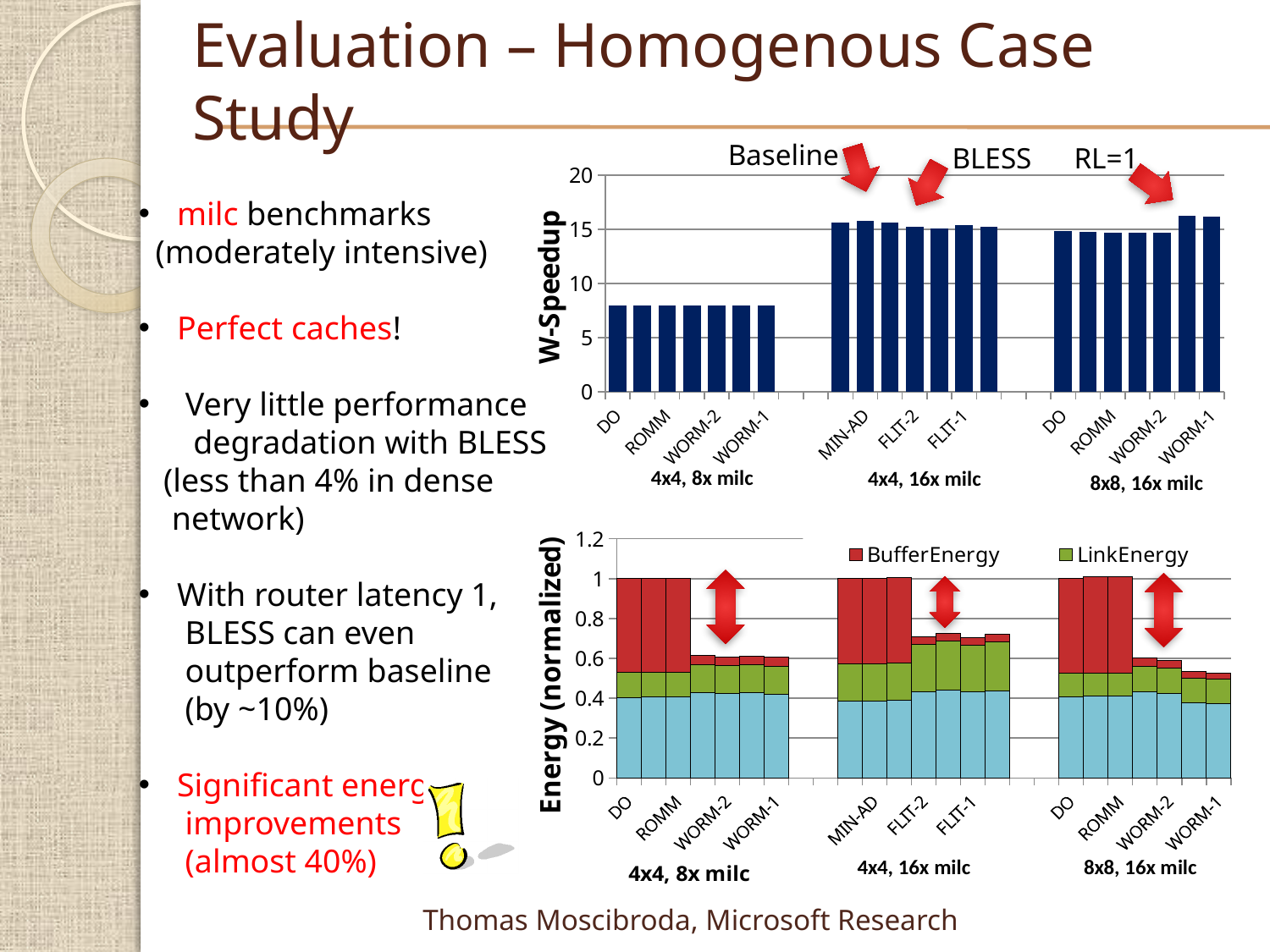
What kind of chart is the top chart (W-Speedup)? bar chart In the top W-Speedup chart, is the value for DO in the 4x4, 8x milc group greater or less than 10? less What kind of chart is the bottom chart (Energy (normalized))? stacked bar chart Which two series are named in the legend of the bottom Energy (normalized) chart? BufferEnergy and LinkEnergy In the top W-Speedup chart, is the value for DO in the 4x4, 8x milc group greater or less than 5? greater In the top W-Speedup chart, which is larger: DO in the 4x4, 8x milc group or DO in the 4x4, 16x milc group? DO in the 4x4, 16x milc group How many configuration groups are shown along the x axis of the top W-Speedup chart? 3 In the bottom Energy (normalized) chart, which has the larger total: DO or WORM-1 in the 4x4, 8x milc group? DO In the bottom Energy (normalized) chart, is the total for DO in the 4x4, 8x milc group greater or less than 0.8? greater In the top W-Speedup chart, how many bars are in the 4x4, 8x milc group? 7